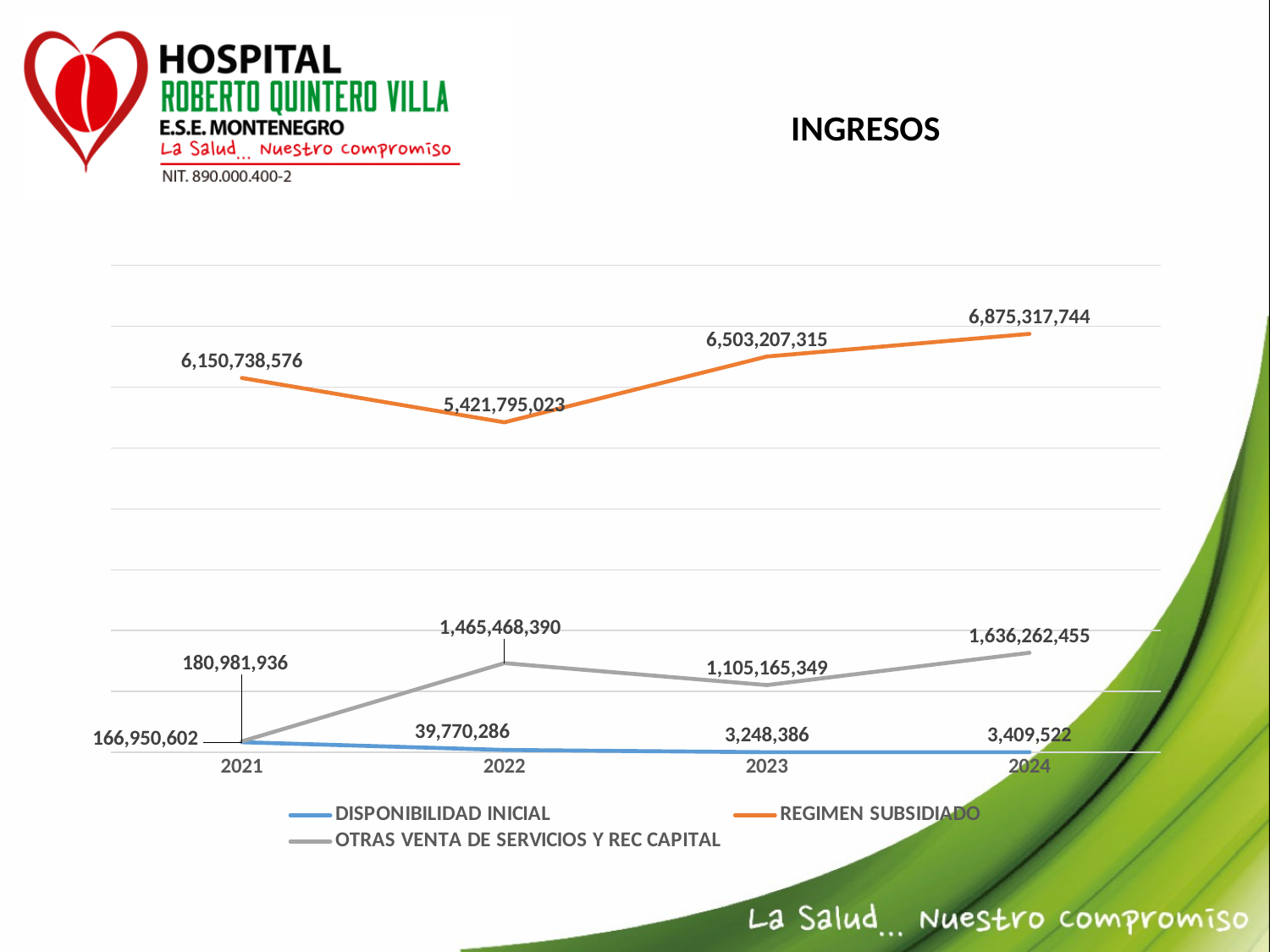
In which year is REGIMEN SUBSIDIADO lowest? 2022 In which year is OTRAS VENTA DE SERVICIOS Y REC CAPITAL highest? 2024 What is the difference between REGIMEN SUBSIDIADO in 2024 and in 2021? 724,579,168 What is the value of DISPONIBILIDAD INICIAL in 2021? 166,950,602 What is the value of REGIMEN SUBSIDIADO in 2024? 6,875,317,744 How many series does the legend list? 3 How many years are shown on the x axis? 4 What kind of chart is shown on the slide? Line chart Which is larger, OTRAS VENTA DE SERVICIOS Y REC CAPITAL in 2022 or in 2023? 2022 In which year is DISPONIBILIDAD INICIAL lowest? 2023 What is the difference between DISPONIBILIDAD INICIAL in 2021 and in 2022? 127,180,316 What is the value of OTRAS VENTA DE SERVICIOS Y REC CAPITAL in 2023? 1,105,165,349